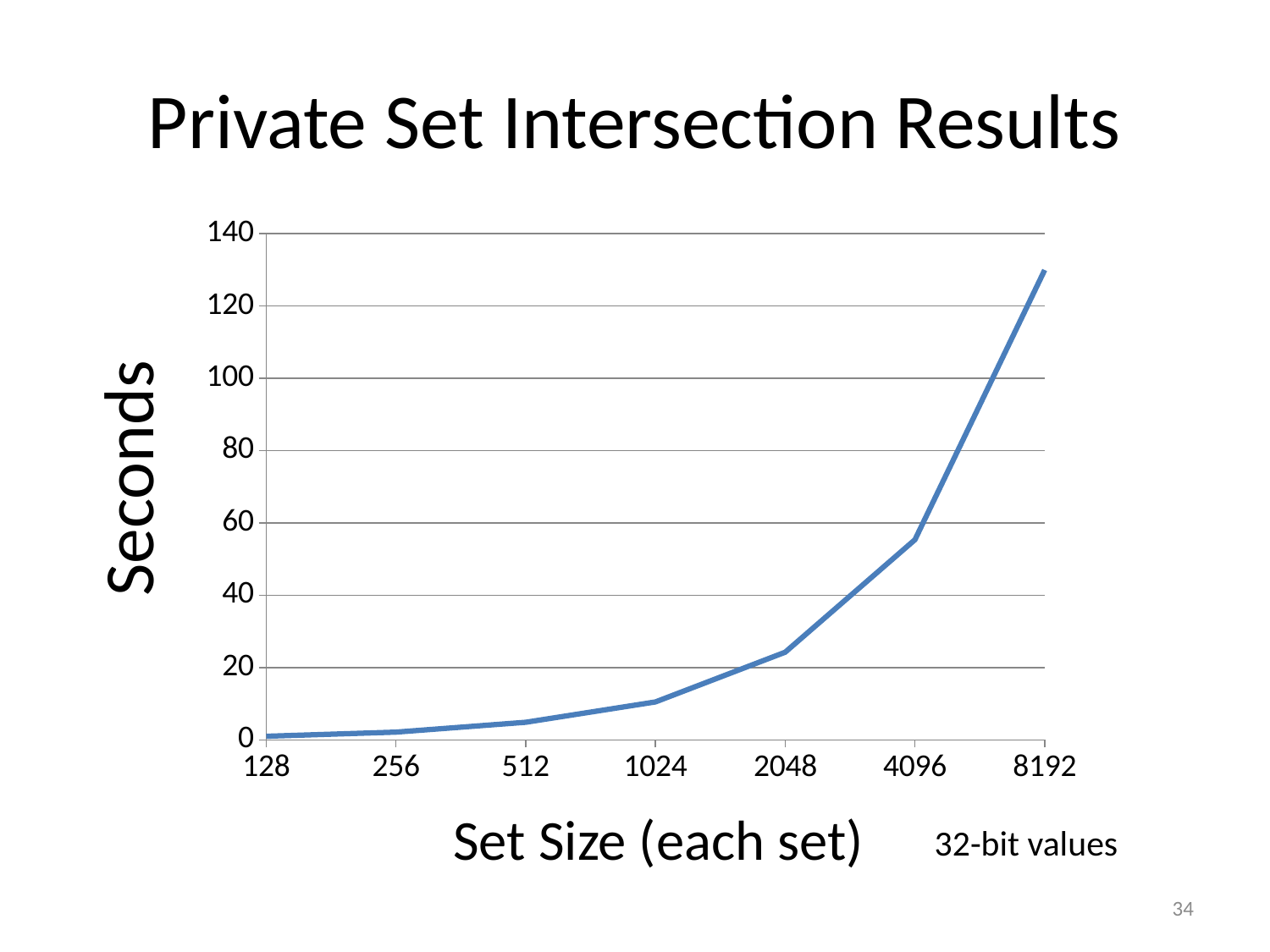
What kind of chart is shown on the slide? line chart Which set size has the highest value in seconds? 8192 How many set sizes are plotted along the x axis? 7 Which has a larger value in seconds, set size 2048 or set size 4096? 4096 Is the value for set size 8192 greater or less than 120 seconds? greater Is the value for set size 1024 greater or less than 20 seconds? less Do the values rise or fall as the set size increases along the x axis? rise What is the label of the y axis? Seconds Which set size has the lowest value in seconds? 128 What is the title of the chart? Private Set Intersection Results Is the value for set size 4096 greater or less than 60 seconds? less